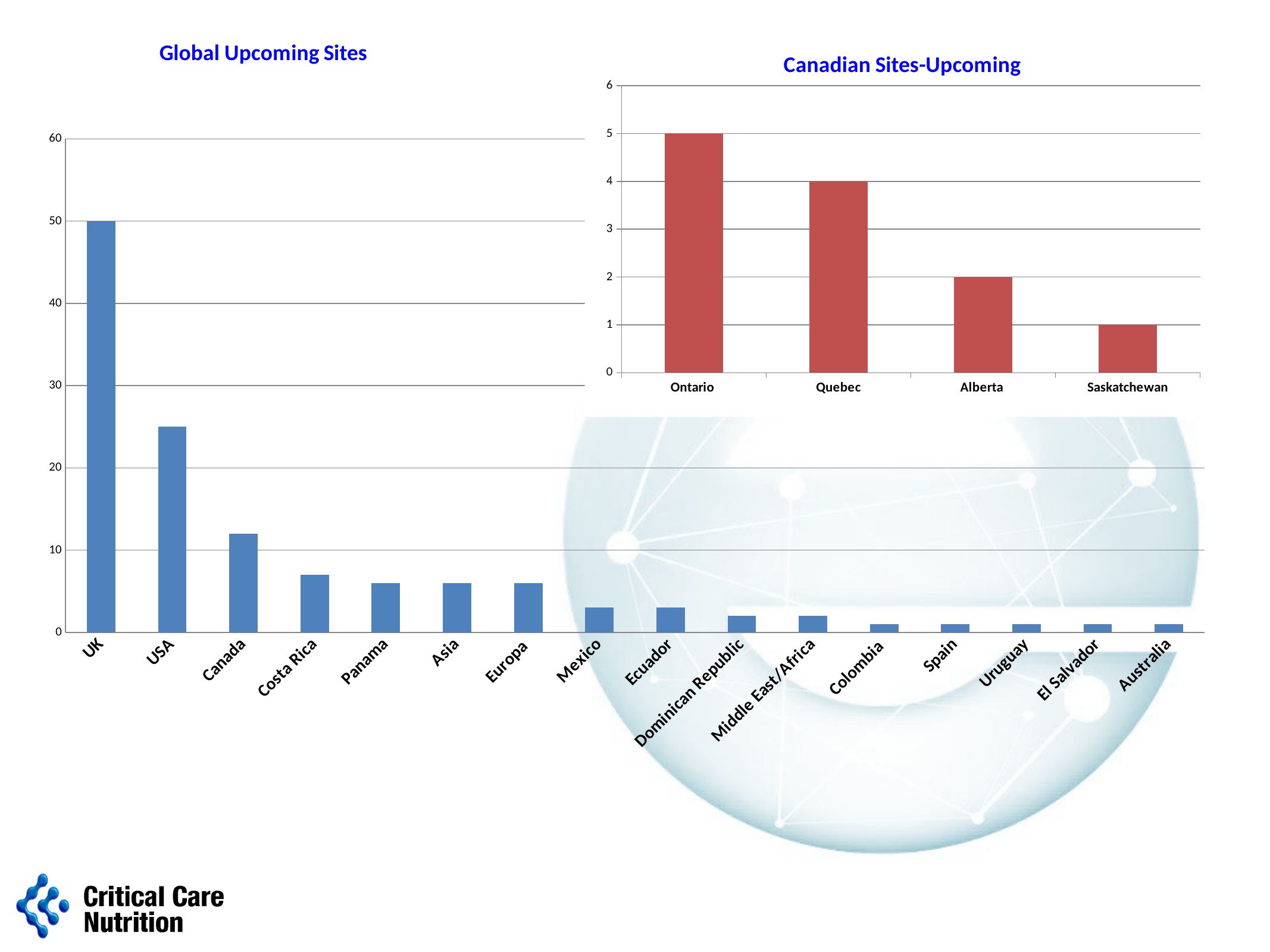
In the Canadian Sites-Upcoming chart, what is the value for Ontario? 5 In the Canadian Sites-Upcoming chart, which province has the lowest value? Saskatchewan In the Global Upcoming Sites chart, how many categories are shown on the x axis? 16 In the Canadian Sites-Upcoming chart, what is the difference between Ontario and Alberta? 3 In the Canadian Sites-Upcoming chart, what is the value for Saskatchewan? 1 In the Global Upcoming Sites chart, which is larger, the value for USA or the value for Canada? USA In the Global Upcoming Sites chart, is the value for USA greater or less than 20? greater In the Canadian Sites-Upcoming chart, how many provinces are shown? 4 In the Global Upcoming Sites chart, which category has the highest value? UK In the Canadian Sites-Upcoming chart, what is the value for Quebec? 4 In the Global Upcoming Sites chart, what is the value for UK? 50 In the Global Upcoming Sites chart, is the value for Canada greater or less than 20? less